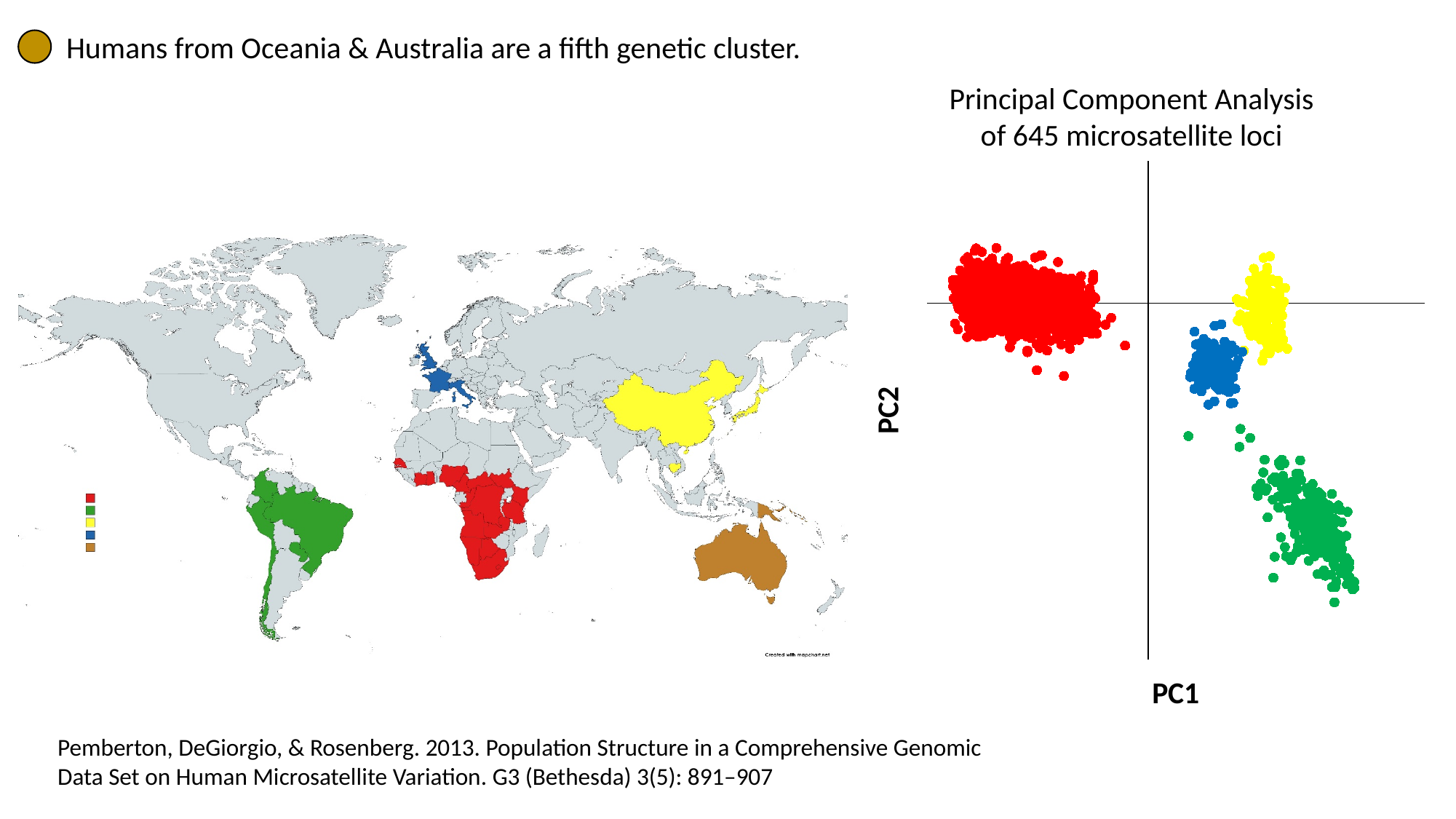
What is the title of the scatter plot on the right? Principal Component Analysis of 645 microsatellite loci In the scatter plot, which coloured cluster lies furthest to the right along PC1? Green In the scatter plot, which coloured cluster lies lowest along PC2? Green How many colours are listed in the legend of the world map? 5 What is the label of the horizontal axis of the scatter plot? PC1 In the scatter plot, is the red cluster to the left or to the right of the vertical PC2 axis line? Left What kind of chart is shown on the right side of the slide? Scatter plot In the scatter plot, which cluster is higher along PC2, the blue cluster or the green cluster? Blue In the scatter plot, is the green cluster above or below the horizontal PC1 axis line? Below How many differently coloured clusters of points are plotted in the scatter plot? 4 In the scatter plot, which coloured cluster lies furthest to the left along PC1? Red